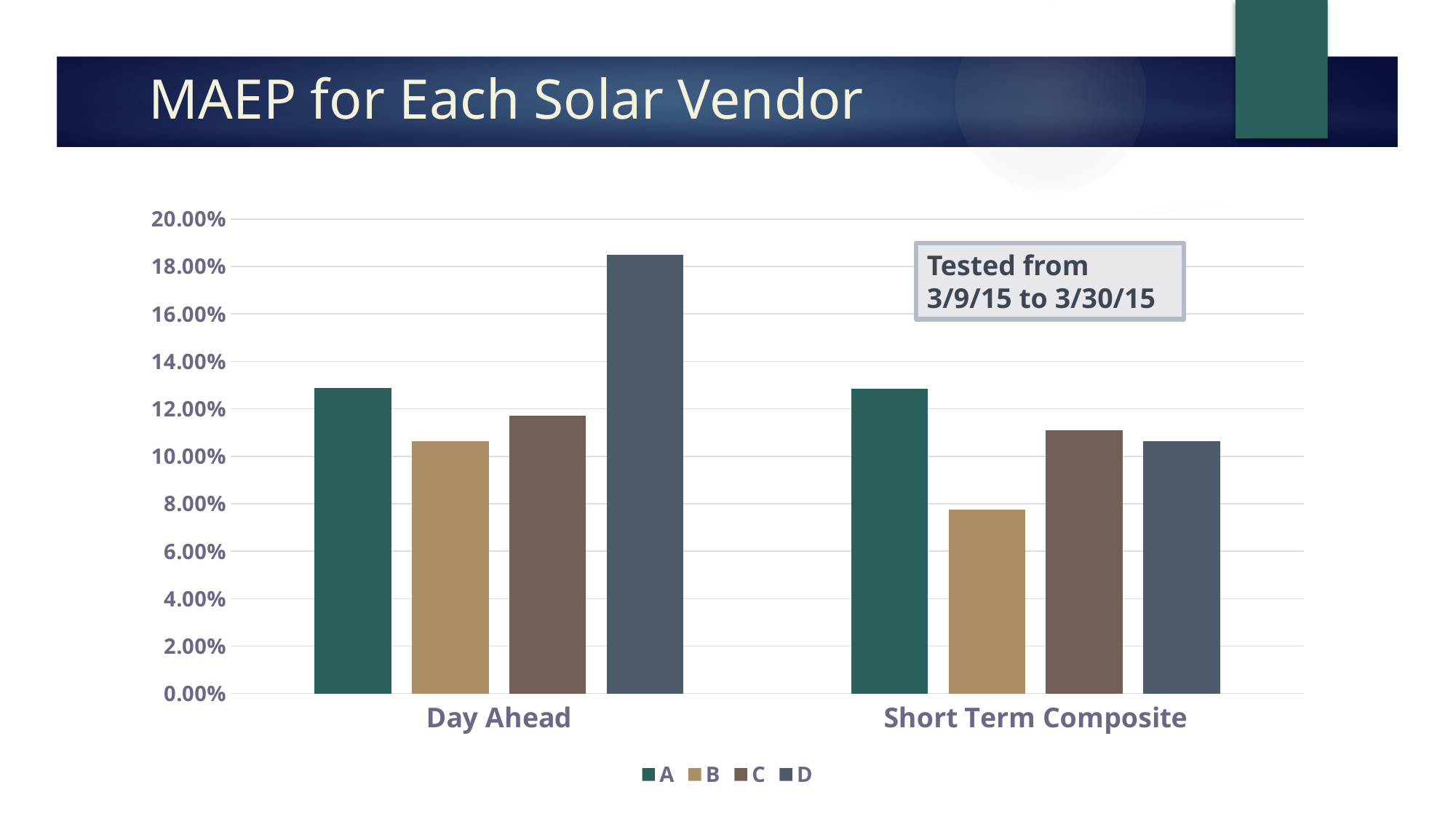
Which vendor has the highest MAEP in the Short Term Composite category? A Is the value for vendor D in the Day Ahead category greater or less than 16.00%? greater Is the value for vendor A in the Day Ahead category greater or less than 12.00%? greater Which vendor has the lowest MAEP in the Day Ahead category? B What kind of chart is shown on the slide? bar chart Is the value for vendor B in the Short Term Composite category greater or less than 10.00%? less How many series does the legend list? 4 Which vendor has the highest MAEP in the Day Ahead category? D Which vendor has the lowest MAEP in the Short Term Composite category? B Which is larger: vendor D's value for Day Ahead or vendor D's value for Short Term Composite? Day Ahead How many categories are shown on the x axis? 2 What is the title of the chart on the slide? MAEP for Each Solar Vendor